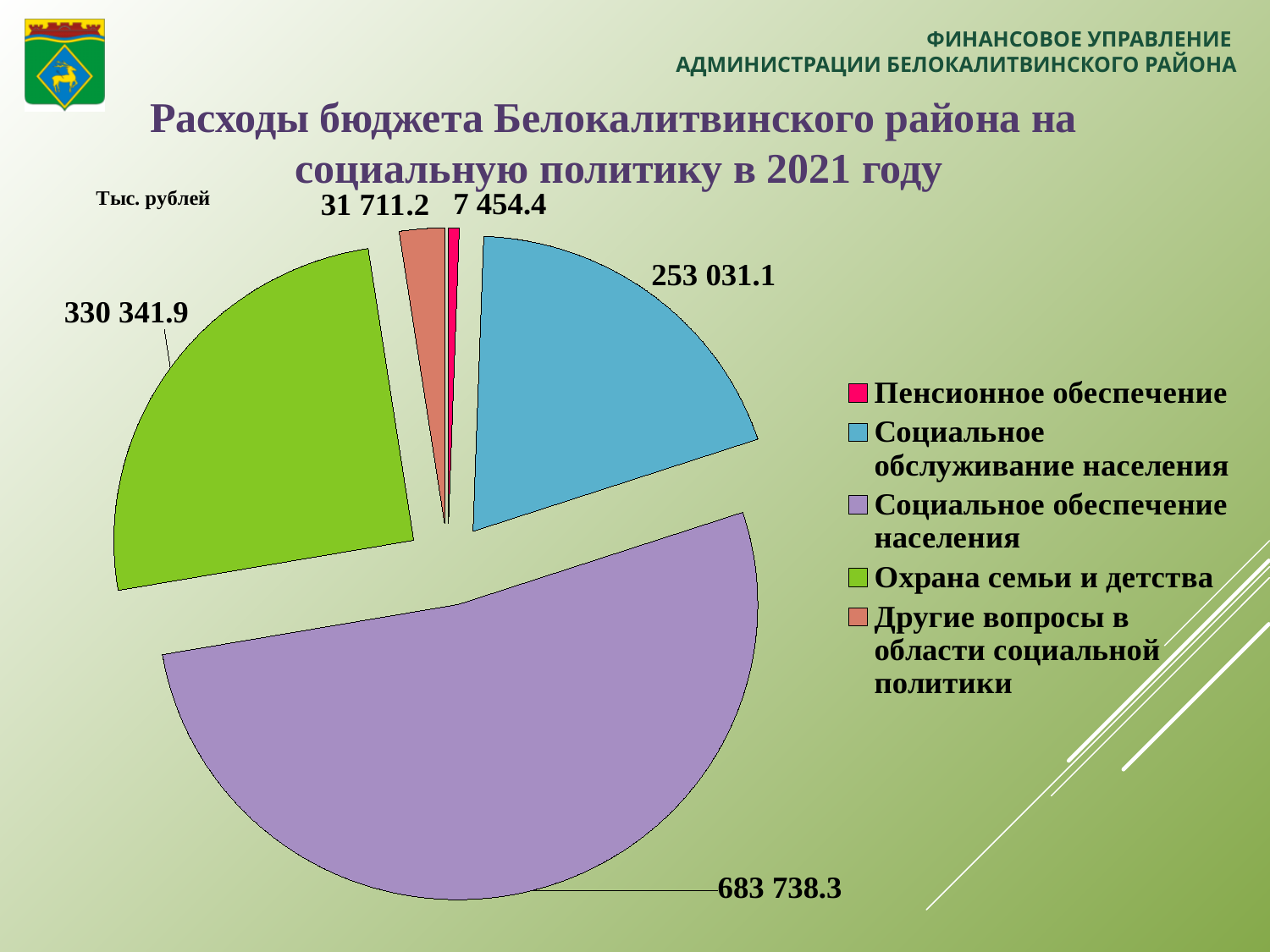
What is the difference between the values for Социальное обеспечение населения and Охрана семьи и детства? 353 396.4 What type of chart is shown on the slide? Pie chart What is the value for Социальное обслуживание населения? 253 031.1 What is the value for Пенсионное обеспечение? 7 454.4 Which category has the largest slice of the pie? Социальное обеспечение населения Which is larger: Охрана семьи и детства or Социальное обслуживание населения? Охрана семьи и детства Which category has the smallest slice of the pie? Пенсионное обеспечение What is the value for Другие вопросы в области социальной политики? 31 711.2 What unit is indicated for the values in the chart? Тыс. рублей What is the value for Социальное обеспечение населения? 683 738.3 How many categories does the pie chart have? 5 What is the value for Охрана семьи и детства? 330 341.9